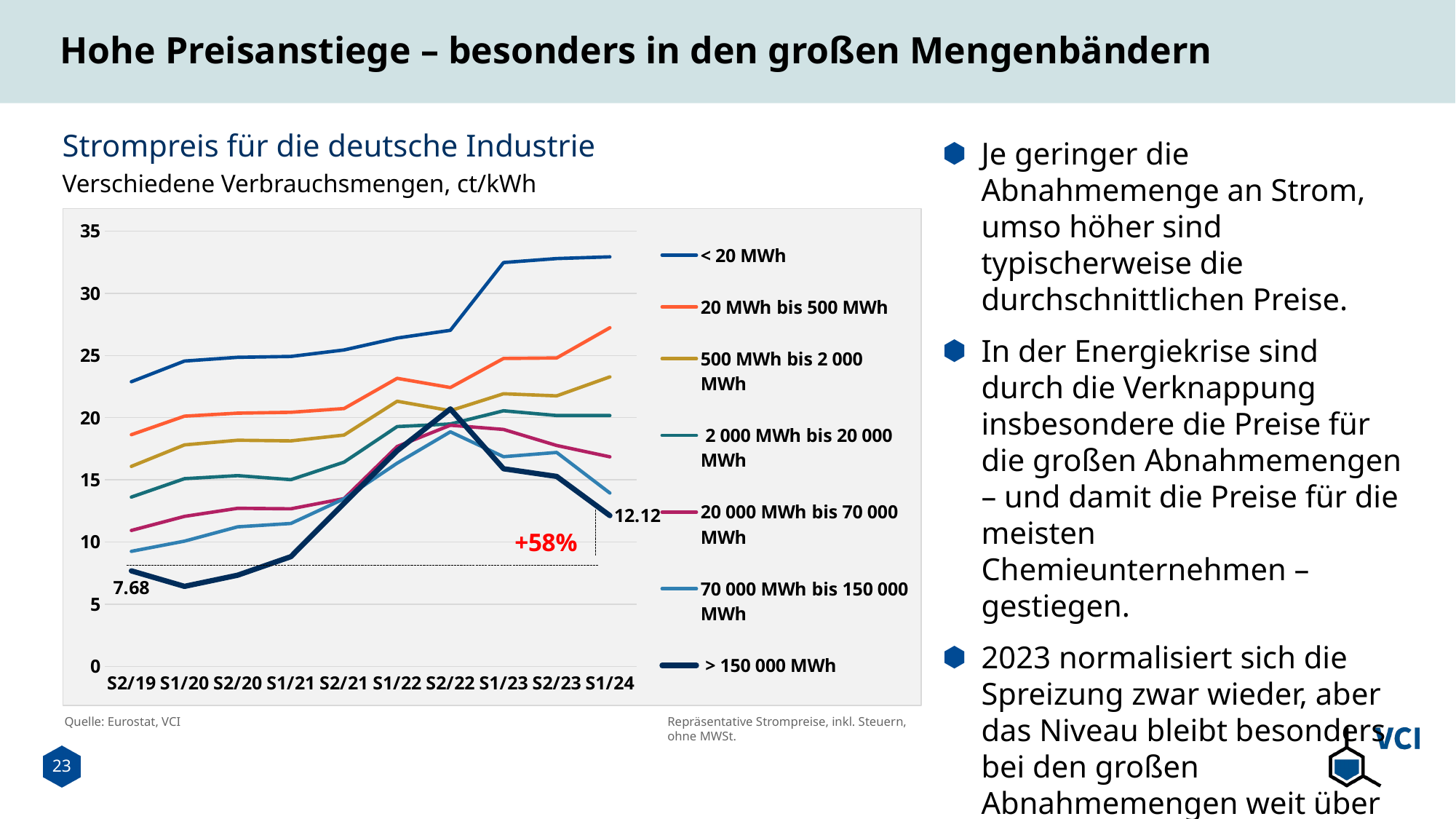
Does the < 20 MWh series rise or fall from S2/19 to S1/24? rise Is the value for the 20 MWh bis 500 MWh series at S2/19 greater or less than 20? less How many time periods are shown on the x axis of the chart? 10 Which series has the lowest value at S1/24? > 150 000 MWh What kind of chart is shown on the slide? line chart How many series does the legend of the chart list? 7 Is the value for the < 20 MWh series at S1/24 greater or less than 30? greater Which series has the highest value at S1/24? < 20 MWh What percentage change is annotated on the chart for the > 150 000 MWh series? +58% By how much did the > 150 000 MWh series increase from S2/19 to S1/24? 4.44 What is the value for the > 150 000 MWh series at S2/19? 7.68 What is the value for the > 150 000 MWh series at S1/24? 12.12